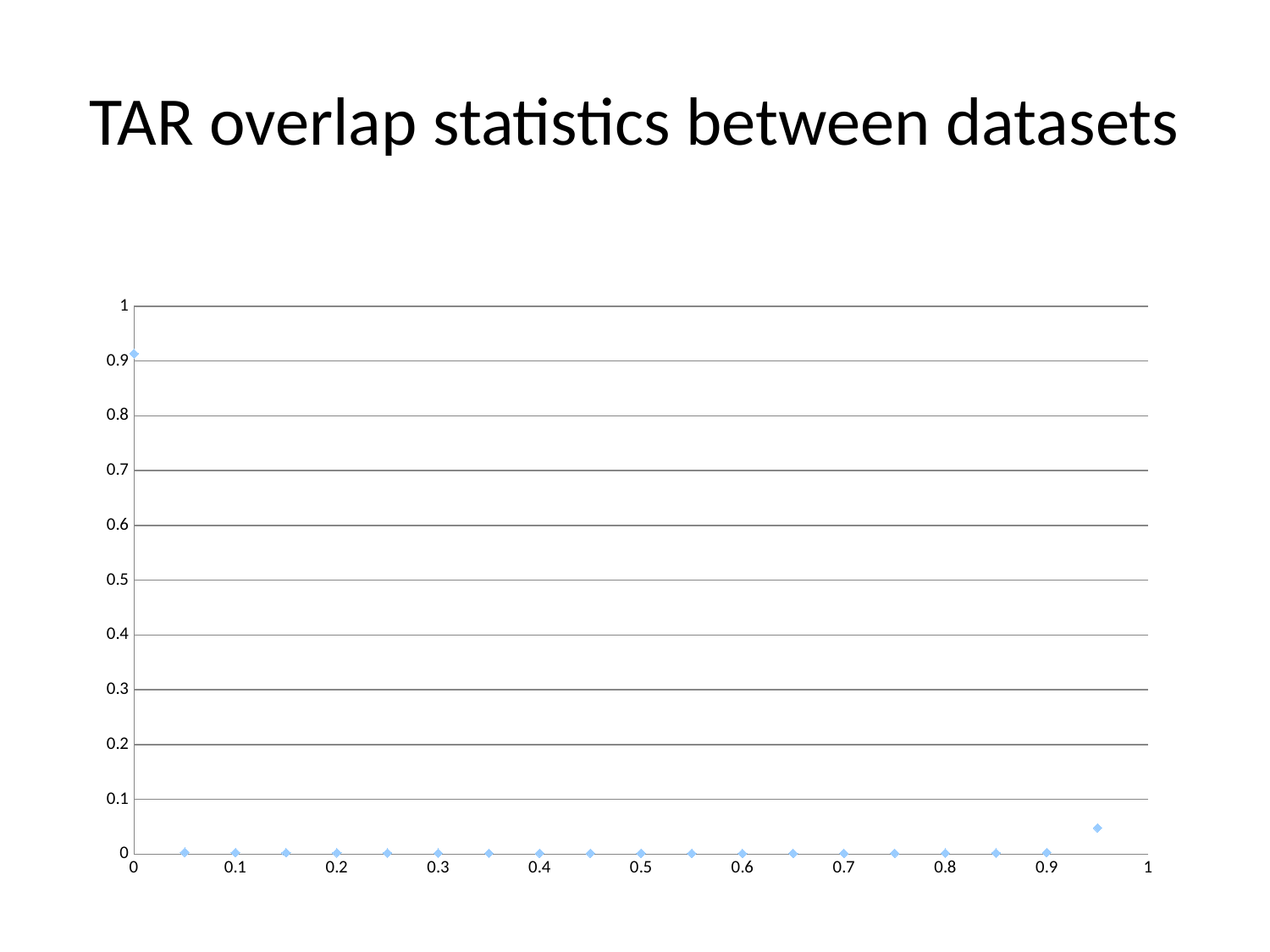
At which x value does the chart's highest point occur? 0 How many data points are plotted on the chart? 20 Is the value of the point at x = 0 greater or less than 0.8? greater Is the value of the point at x = 0.5 greater or less than 0.1? less Is the value of the point at x = 0.95 greater or less than 0.1? less What is the maximum value shown on the chart's y axis? 1 What is the title of the slide containing the chart? TAR overlap statistics between datasets Which point has the larger value: the one at x = 0 or the one at x = 0.95? x = 0 What kind of chart is shown on the slide? scatter chart Which point has the larger value: the one at x = 0.95 or the one at x = 0.5? x = 0.95